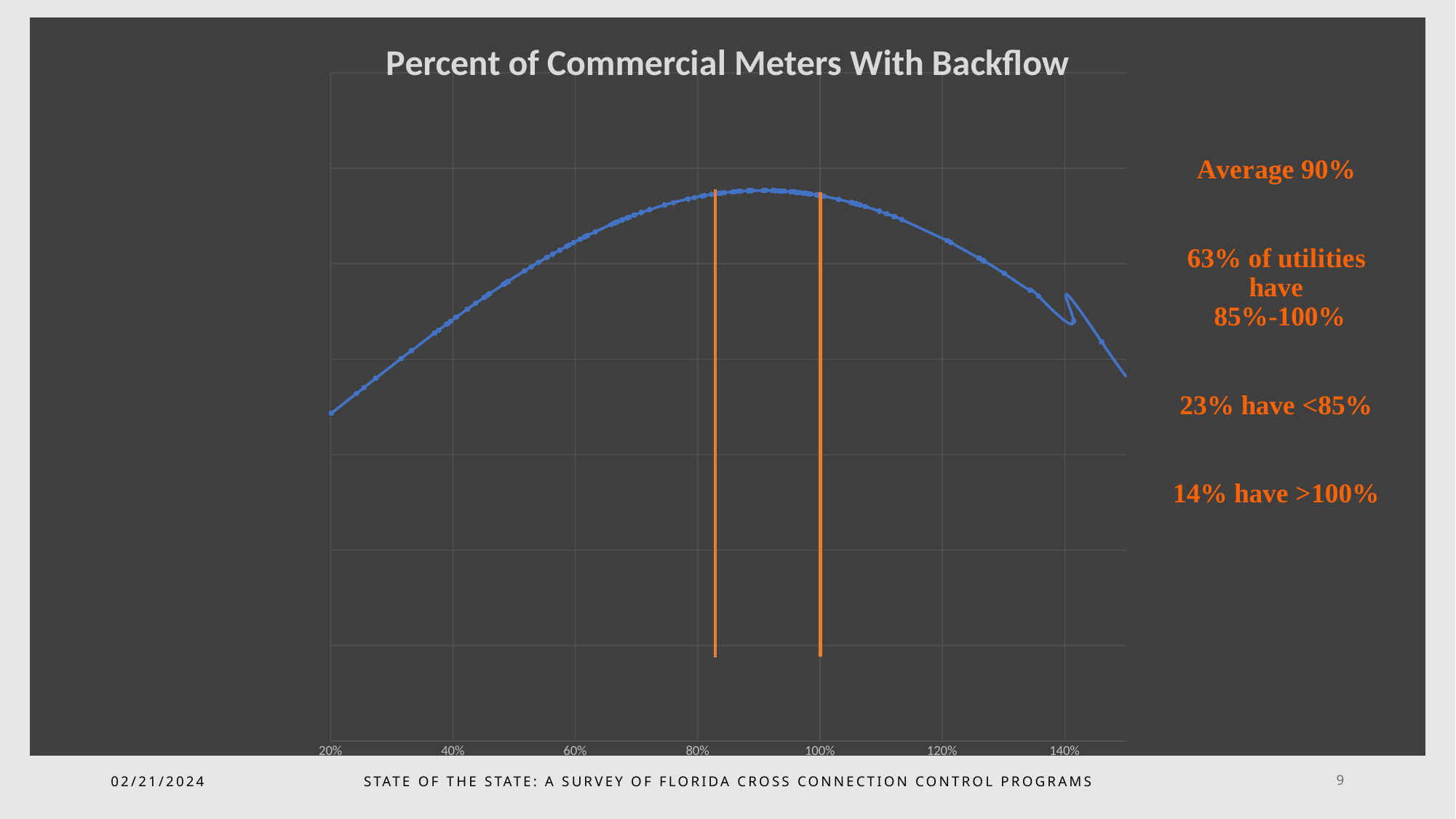
Does the curve rise or fall along the x axis between 20% and 80%? rise According to the annotation beside the chart, what is the average percent of commercial meters with backflow? 90% What is the lowest value labelled on the x axis? 20% Is the peak of the curve located at an x value greater or less than 60%? greater According to the annotations beside the chart, which is larger: the share of utilities with <85% or the share with >100%? <85% What kind of chart is shown on the slide? line chart How many labelled tick marks are shown on the x axis? 7 According to the annotation beside the chart, what percent of utilities have 85%-100%? 63% What is the title of the chart? Percent of Commercial Meters With Backflow Does the curve rise or fall along the x axis between 100% and 140%? fall How many orange vertical lines are drawn on the chart? 2 What is the highest value labelled on the x axis? 140%